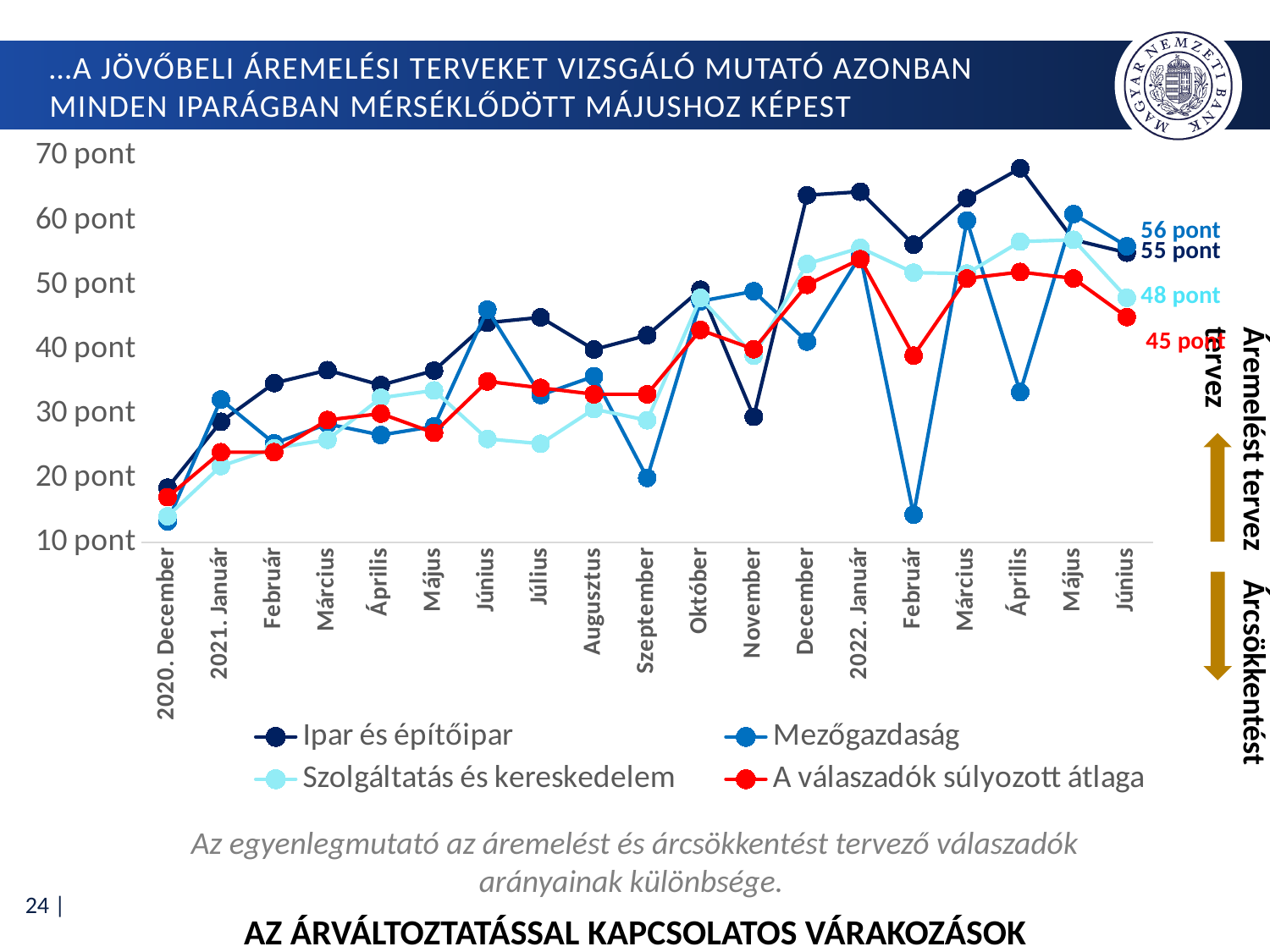
What is the value for Mezőgazdaság in 2022 Június? 56 pont How many series does the legend list? 4 How many months are shown on the x axis? 19 What is the value for A válaszadók súlyozott átlaga in 2022 Június? 45 pont Is the value for Mezőgazdaság in 2022 Február greater or less than 20 pont? less What is the difference between the 2022 Június values of Mezőgazdaság and A válaszadók súlyozott átlaga? 11 pont In which month does the Ipar és építőipar series reach its highest value? 2022 Április In 2022 Június, which is larger: Mezőgazdaság or A válaszadók súlyozott átlaga? Mezőgazdaság What is the value for Ipar és építőipar in 2022 Június? 55 pont What type of chart is shown on the slide? line chart Is the value for Ipar és építőipar in 2021 December greater or less than 60 pont? greater What is the value for Szolgáltatás és kereskedelem in 2022 Június? 48 pont